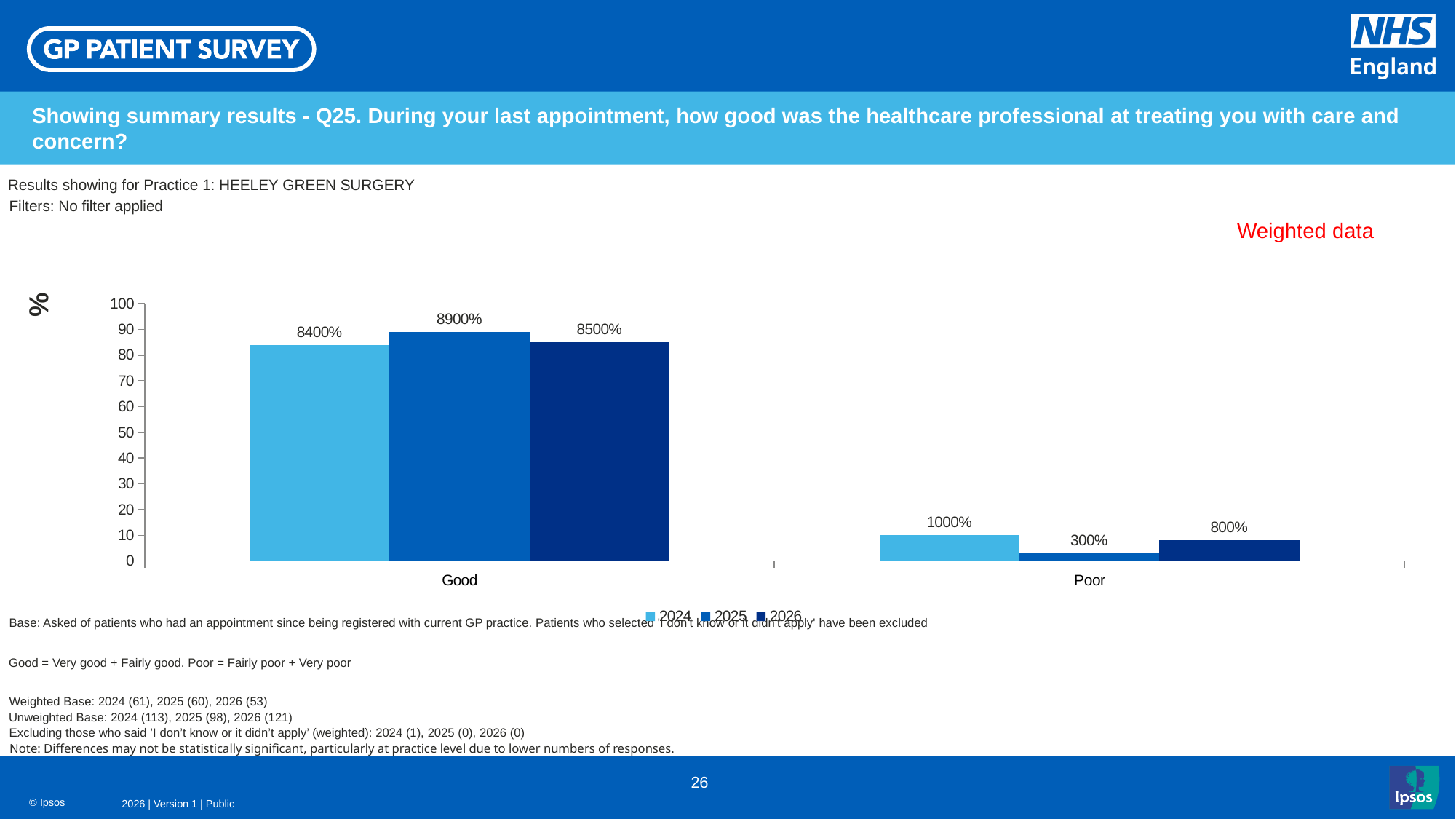
Is the 2024 bar for Good larger or smaller than the 2026 bar for Good? smaller What kind of chart is shown on the slide? bar chart Which year has the lowest bar in the Poor category? 2025 What is the data label for 2025 in the Poor category? 300% Is the 2024 bar for Poor greater or less than 20 on the axis? less What is the data label for 2024 in the Good category? 8400% How many categories are shown on the x axis? 2 What is the data label for 2025 in the Good category? 8900% What are the series names listed in the legend? 2024, 2025, 2026 Which year has the highest bar in the Good category? 2025 How many series does the legend list? 3 What is the data label for 2026 in the Poor category? 800%